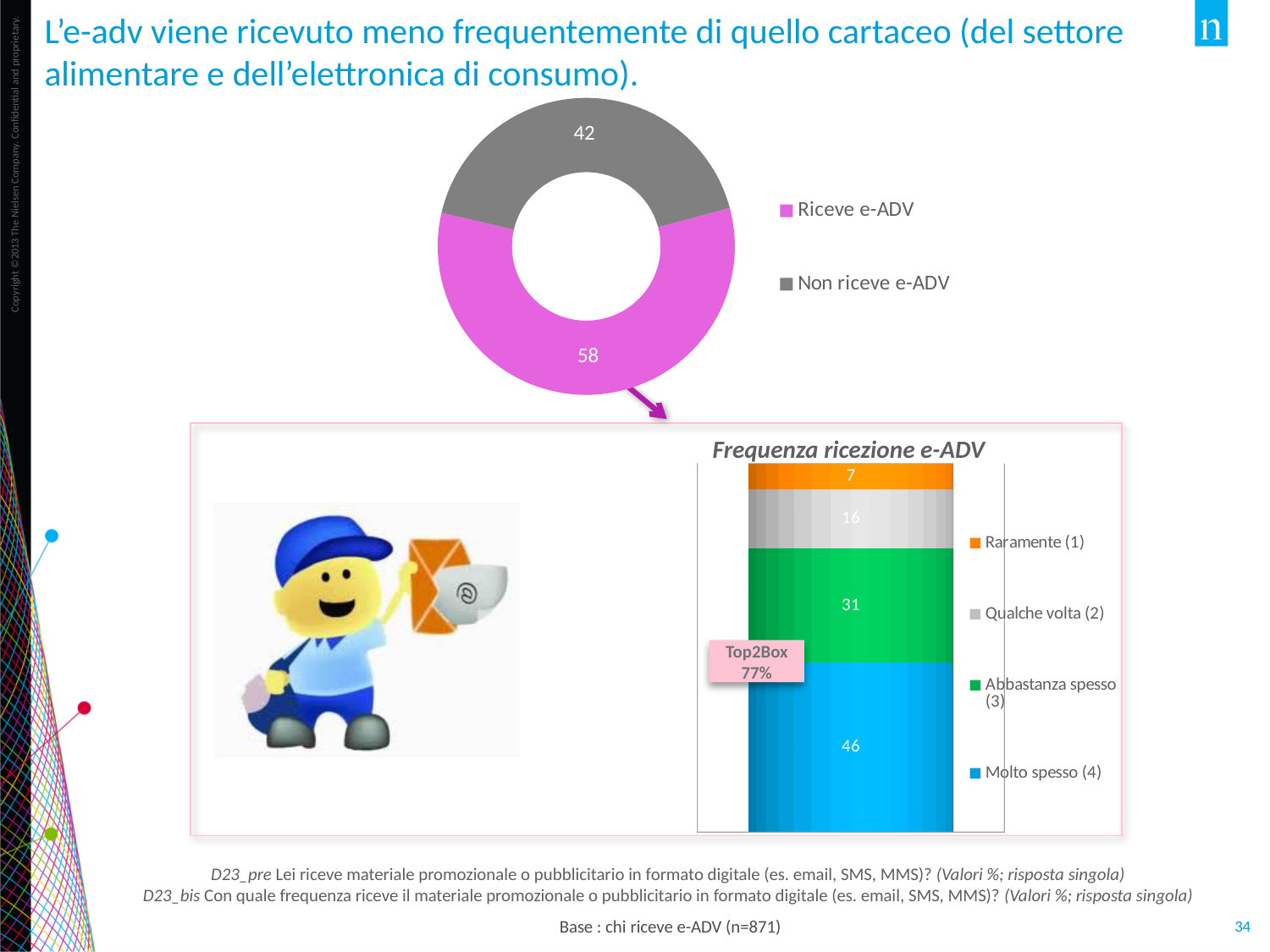
In the "Frequenza ricezione e-ADV" chart, which category has the lowest value? Raramente (1) In the "Frequenza ricezione e-ADV" chart, what is the value for "Molto spesso (4)"? 46 In the donut chart at the top of the slide, what is the value for "Non riceve e-ADV"? 42 In the donut chart at the top of the slide, what is the difference between the values for "Riceve e-ADV" and "Non riceve e-ADV"? 16 In the donut chart at the top of the slide, what is the value for "Riceve e-ADV"? 58 What kind of chart is the chart at the top of the slide? Donut chart In the "Frequenza ricezione e-ADV" chart, what is the difference between "Molto spesso (4)" and "Abbastanza spesso (3)"? 15 In the donut chart at the top of the slide, how many categories does the legend list? 2 In the "Frequenza ricezione e-ADV" chart, what is the total of the stacked bar? 100 In the "Frequenza ricezione e-ADV" chart, how many series does the legend list? 4 In the donut chart at the top of the slide, which category has the larger value? Riceve e-ADV In the "Frequenza ricezione e-ADV" chart, what is the value for "Qualche volta (2)"? 16